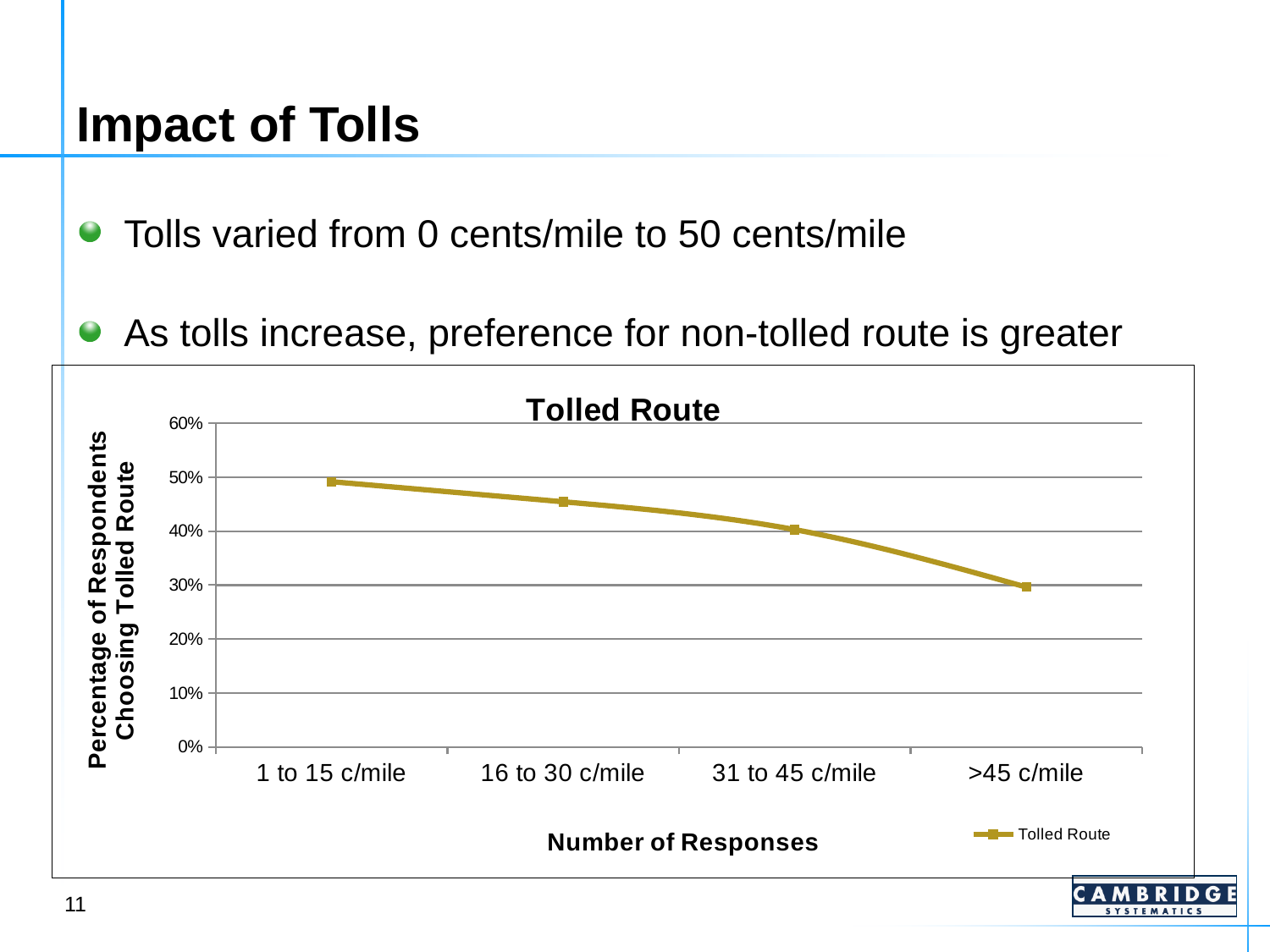
What is the label on the vertical axis of the chart? Percentage of Respondents Choosing Tolled Route How many toll categories are plotted along the x axis? 4 Which toll category has the lowest percentage of respondents choosing the tolled route? >45 c/mile How many series does the legend list? 1 What kind of chart is shown on the slide? line chart Is the value for 31 to 45 c/mile greater or less than 30%? greater Is the value for 16 to 30 c/mile greater or less than 50%? less Which toll category has the highest percentage of respondents choosing the tolled route? 1 to 15 c/mile Do the values rise or fall as the toll categories increase along the x axis? fall Which is larger, the value for 1 to 15 c/mile or the value for >45 c/mile? 1 to 15 c/mile Is the value for >45 c/mile greater or less than 40%? less What is the title of the chart? Tolled Route